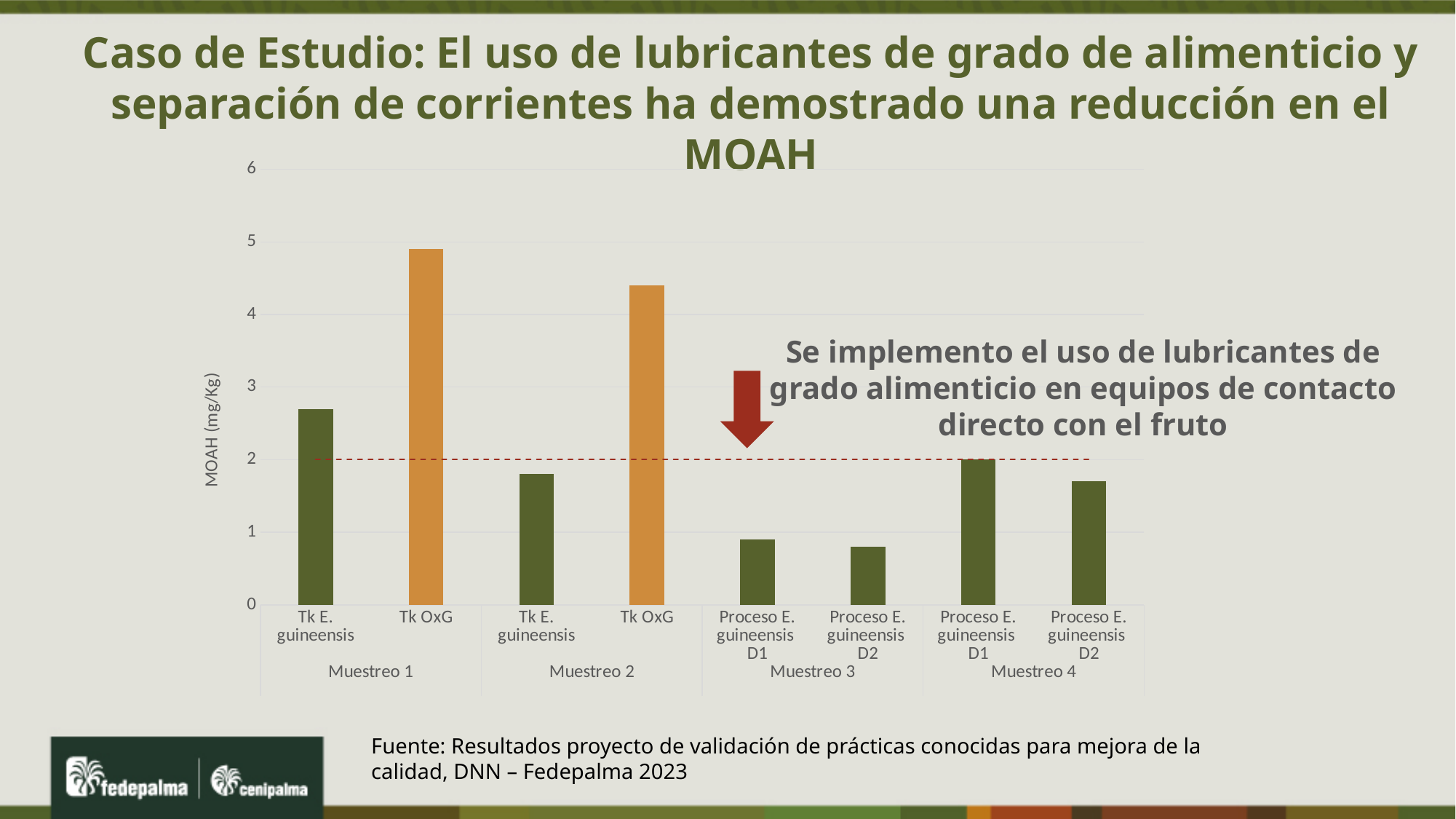
Is the value for Proceso E. guineensis D1 in Muestreo 3 greater or less than 1? less Is the value for Tk E. guineensis in Muestreo 1 greater or less than 2? greater How many bars are plotted in the chart? 8 Which bar has the highest MOAH value? Tk OxG in Muestreo 1 What kind of chart is shown on the slide? bar chart How many sampling groups (Muestreo) are shown along the x axis? 4 What is the label of the vertical axis? MOAH (mg/Kg) At what value on the y axis is the red dashed horizontal line drawn? 2 Is the value for Tk E. guineensis in Muestreo 2 greater or less than 2? less Which is larger: Tk OxG in Muestreo 1 or Tk OxG in Muestreo 2? Tk OxG in Muestreo 1